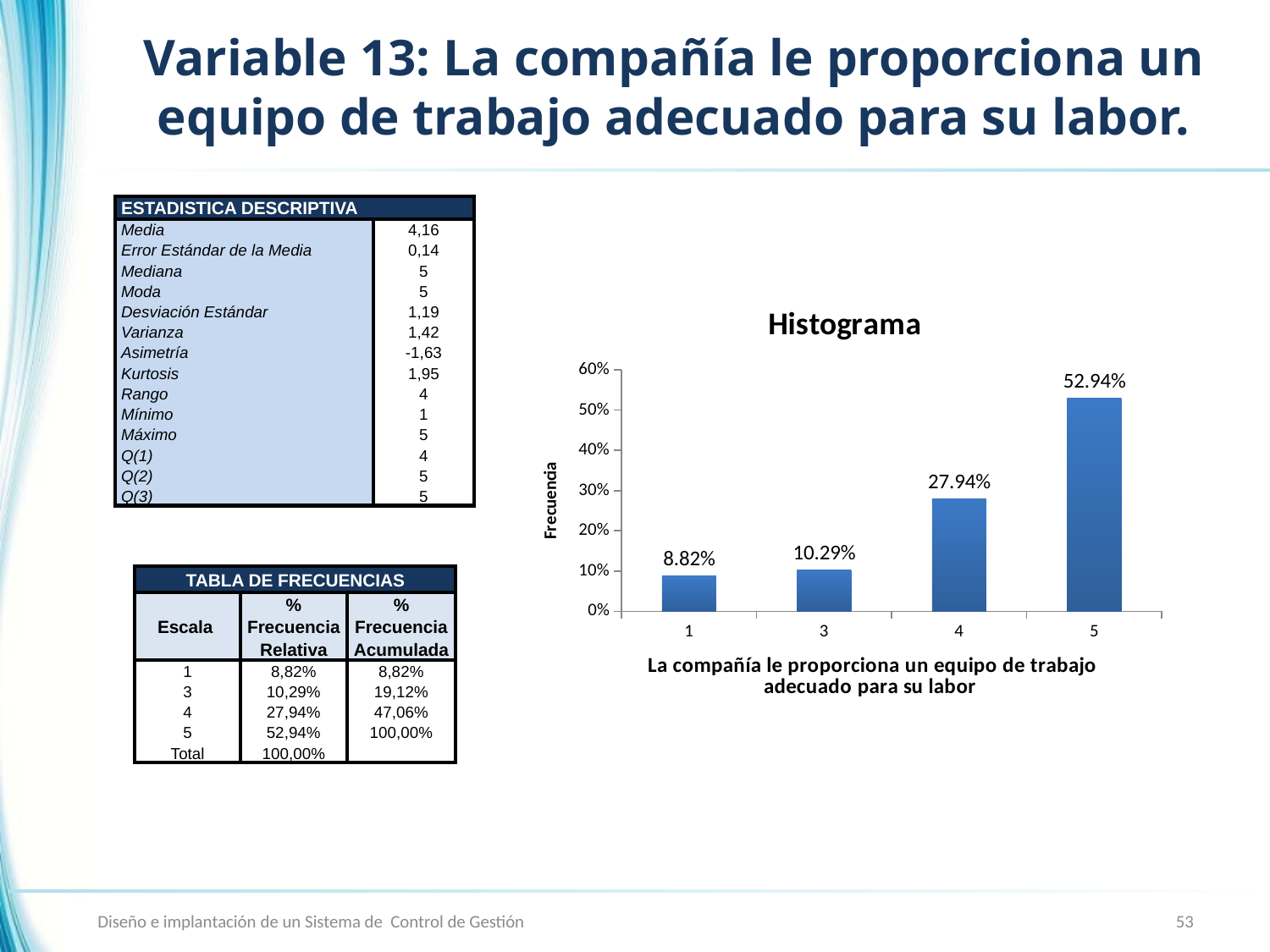
What is the value for category 4 in the Histograma chart? 27.94% Is the value for category 4 in the Histograma chart greater or less than 20%? greater How many categories are shown on the x axis of the Histograma chart? 4 What is the value for category 1 in the Histograma chart? 8.82% What is the y-axis label of the Histograma chart? Frecuencia What is the difference between the values for category 5 and category 4 in the Histograma chart? 25.00% Which category has the highest value in the Histograma chart? 5 What kind of chart is the Histograma chart? bar chart Which is larger in the Histograma chart, the value for category 3 or category 4? 4 Which category has the lowest value in the Histograma chart? 1 What is the value for category 5 in the Histograma chart? 52.94% Do the values in the Histograma chart rise or fall from left to right along the x axis? rise